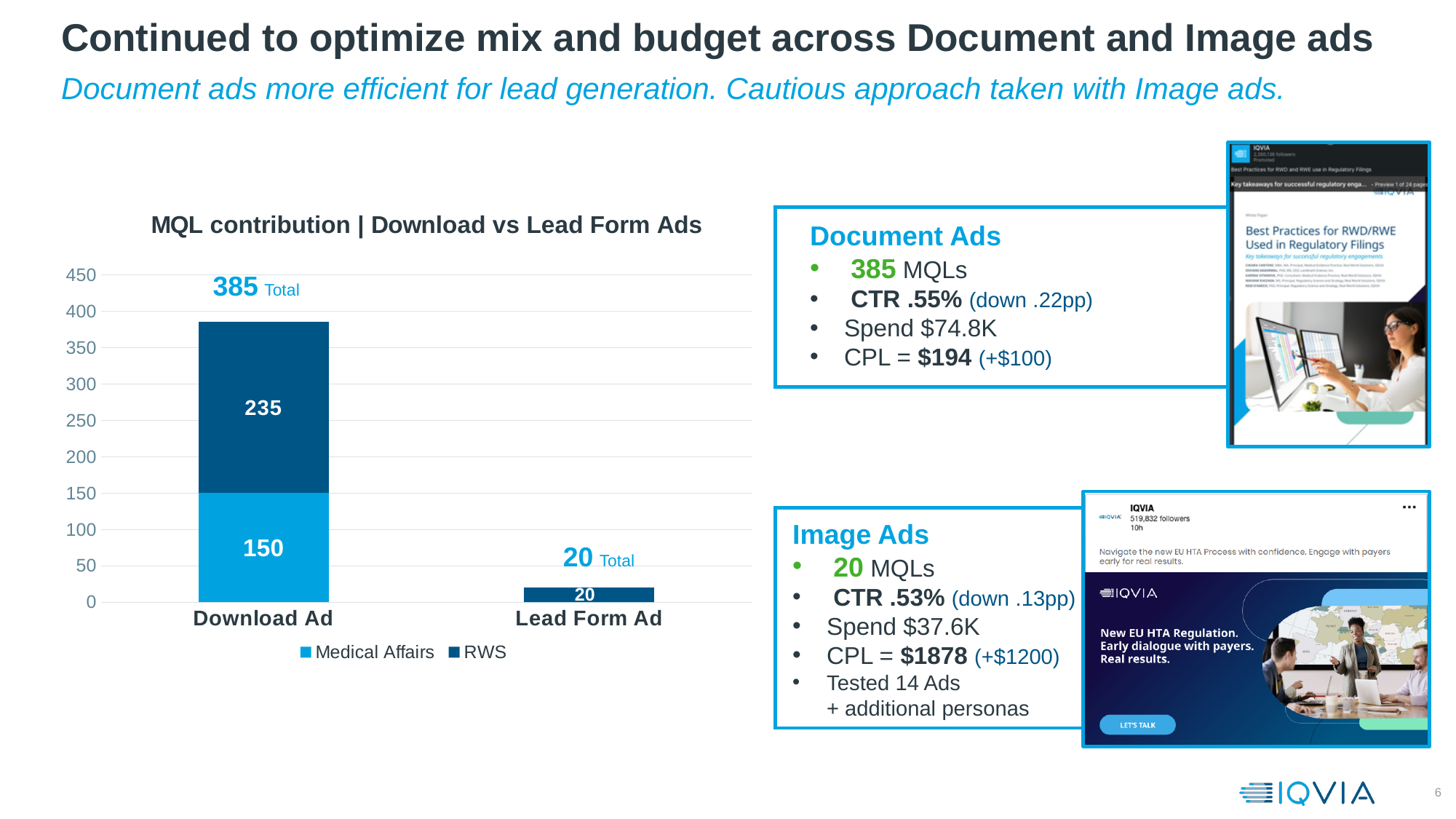
What is the total shown for the Lead Form Ad bar? 20 What is the difference between the RWS and Medical Affairs values for Download Ad? 85 Which category has the lowest total? Lead Form Ad What is the Medical Affairs value for Download Ad? 150 How many categories are shown on the x axis? 2 What is the RWS value for Lead Form Ad? 20 What kind of chart is shown? Stacked bar chart How many series does the legend list? 2 Which category has the highest total? Download Ad What is the RWS value for Download Ad? 235 What is the total shown for the Download Ad bar? 385 Which is larger for Download Ad, the RWS value or the Medical Affairs value? RWS